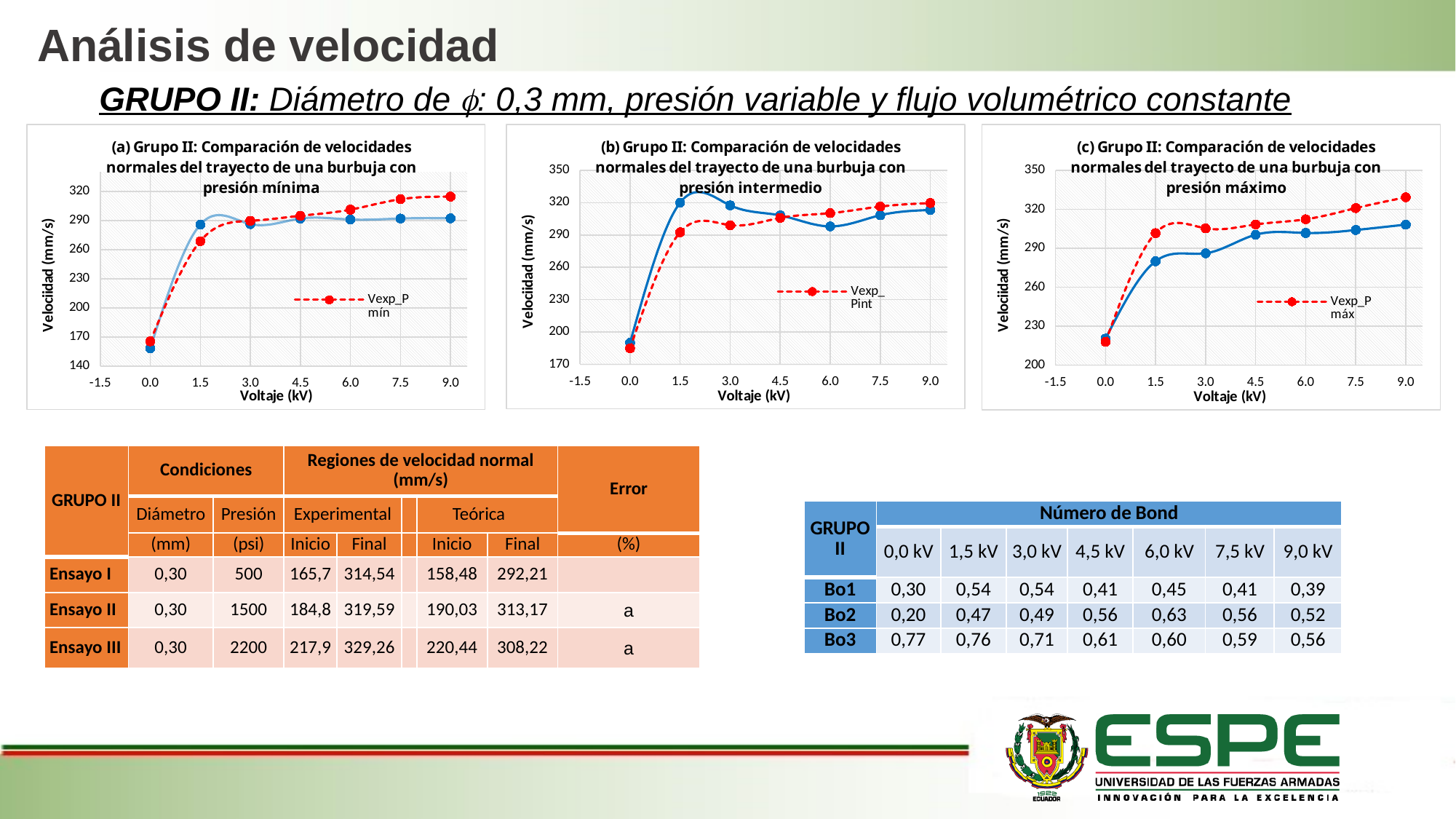
In chart (b) (presión intermedio), is the Vexp_Pint value at 0.0 kV greater or less than 200? less In chart (c) (presión máximo), is the Vexp_P máx value at 9.0 kV greater or less than 320? greater In chart (c) (presión máximo), at which voltage does the Vexp_P máx series reach its highest value? 9.0 kV In chart (c) (presión máximo), at which voltage does the Vexp_P máx series have its lowest value? 0.0 kV In chart (b) (presión intermedio), how many series does the legend list? 1 In chart (c) (presión máximo), at 9.0 kV, which line is higher: the red dashed Vexp_P máx line or the blue solid line? the red dashed Vexp_P máx line In chart (a) (presión mínima), is the Vexp_P mín value at 9.0 kV greater or less than 290? greater What is the y-axis label of chart (b) (presión intermedio)? Velocidad (mm/s) In chart (c) (presión máximo), do the Vexp_P máx values generally rise or fall as voltage increases from 0.0 to 9.0 kV? rise In chart (c) (presión máximo), how many voltage points are plotted for the Vexp_P máx series? 7 What kind of chart is chart (a), 'Grupo II: Comparación de velocidades normales del trayecto de una burbuja con presión mínima'? line chart